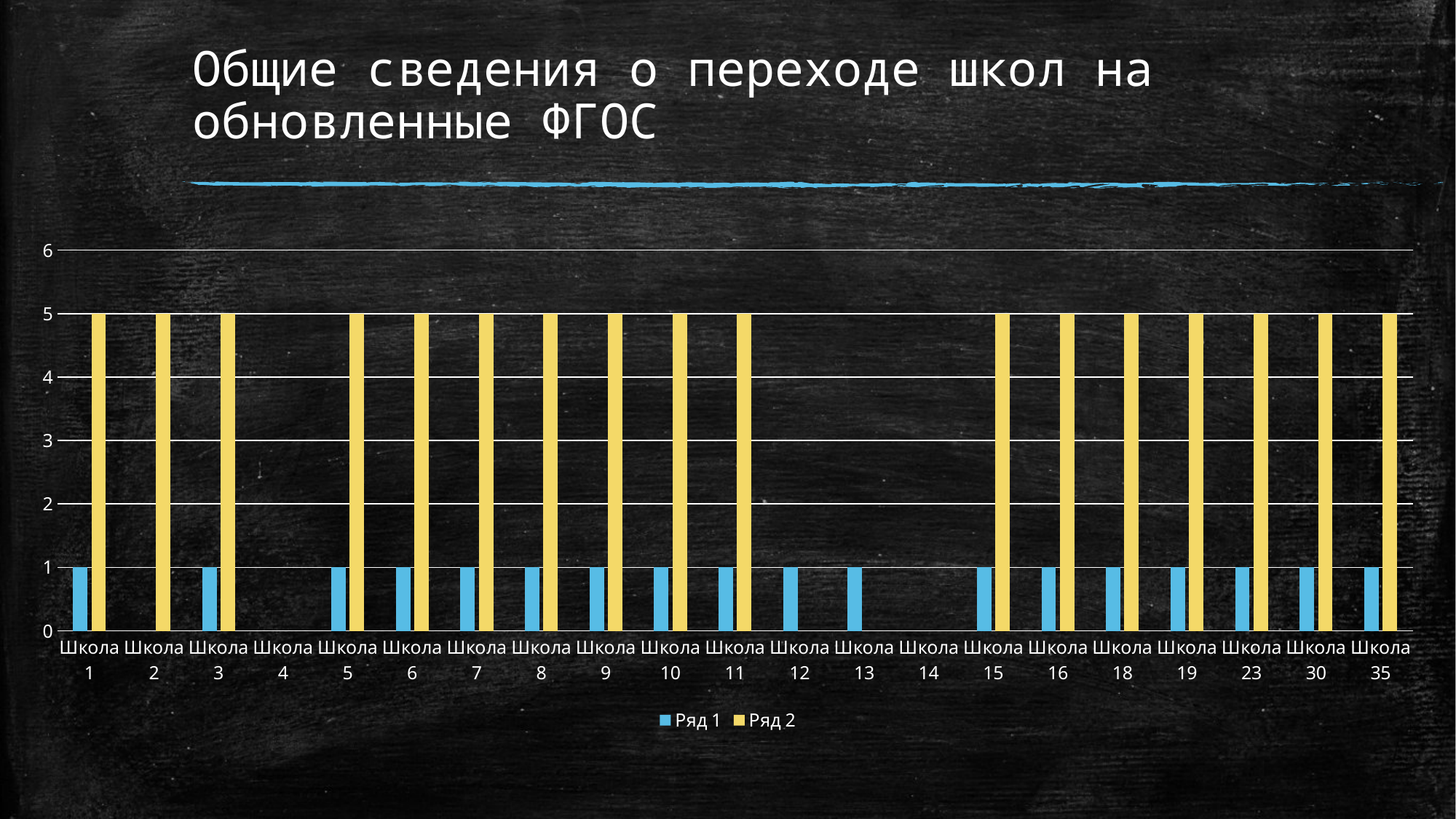
For Школа 3, which series has the larger value, Ряд 1 or Ряд 2? Ряд 2 What is the value of Ряд 2 for Школа 1? 5 What is the highest value reached by any bar in the chart? 5 What are the two legend entries of the chart? Ряд 1, Ряд 2 What kind of chart is shown on the slide? bar chart What colour are the bars for Ряд 2? yellow What is the value of Ряд 1 for Школа 5? 1 Is the value of Ряд 2 for Школа 16 greater or less than 3? greater What is the difference between Ряд 2 and Ряд 1 for Школа 10? 4 What is the value of Ряд 2 for Школа 35? 5 How many series does the legend list? 2 How many school categories are shown on the x axis? 21